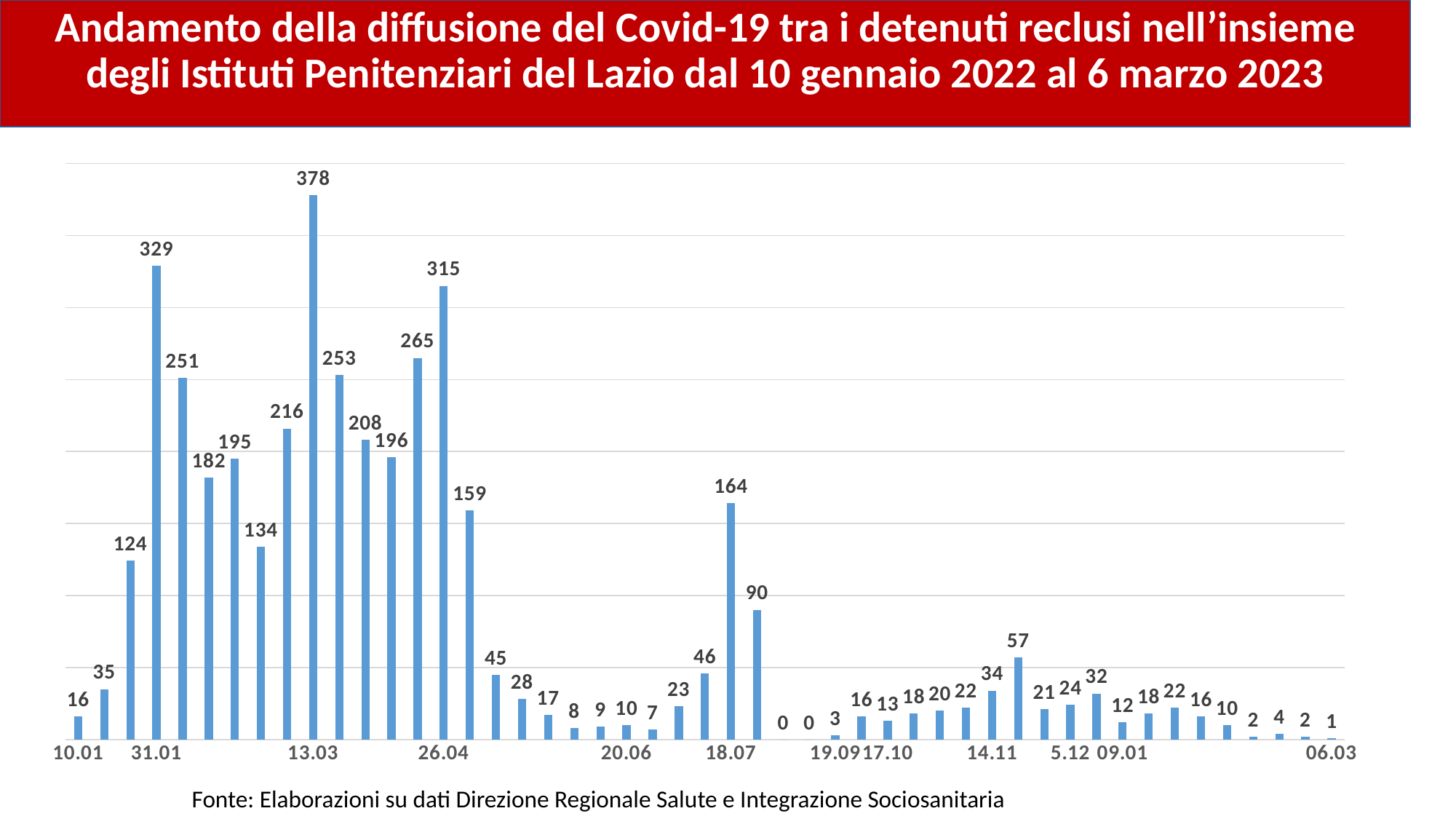
What is the value for 06.03? 1 How many bars are plotted in the chart? 49 Which is larger, the value for 14.11 or the value for 5.12? 14.11 What is the value for 19.09? 3 What is the difference between the values for 13.03 and 26.04? 63 What is the difference between the values for 18.07 and 20.06? 154 What is the value for 18.07? 164 What is the value for 31.01? 329 What type of chart is shown on the slide? bar chart What is the source cited below the chart? Elaborazioni su dati Direzione Regionale Salute e Integrazione Sociosanitaria Which date has the highest value? 13.03 What is the value for 13.03? 378